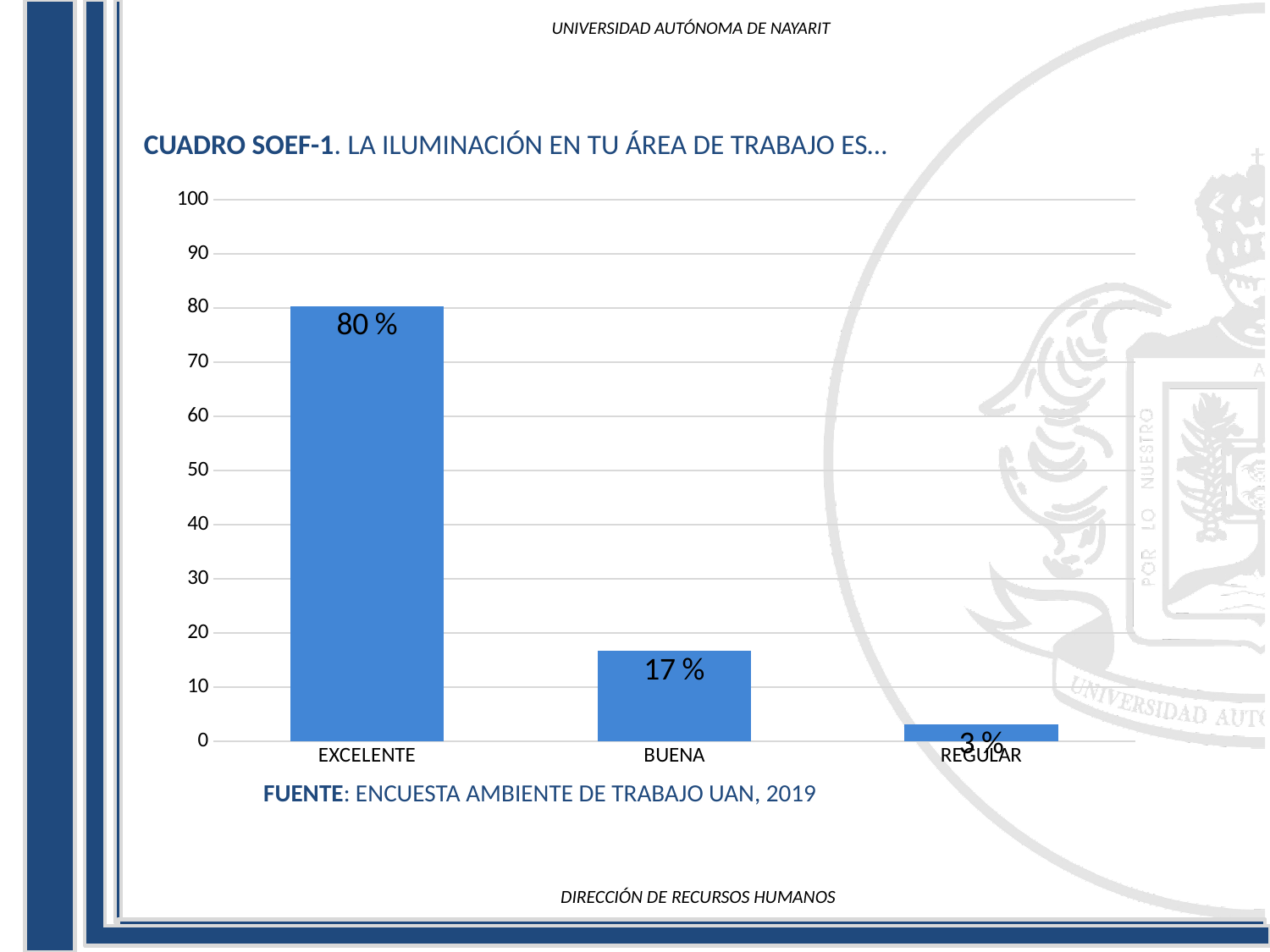
How many categories are shown on the x axis? 3 Which category has the highest value? EXCELENTE What is the value for BUENA? 17 % Is the value for EXCELENTE greater or less than 70? greater What is the difference between the values for EXCELENTE and BUENA? 63 % What is the value for REGULAR? 3 % Do the values rise or fall from left to right along the x axis? fall Which is larger, the value for BUENA or the value for REGULAR? BUENA What is the value for EXCELENTE? 80 % Which category has the lowest value? REGULAR What kind of chart is shown on the slide? bar chart What is the difference between the values for BUENA and REGULAR? 14 %